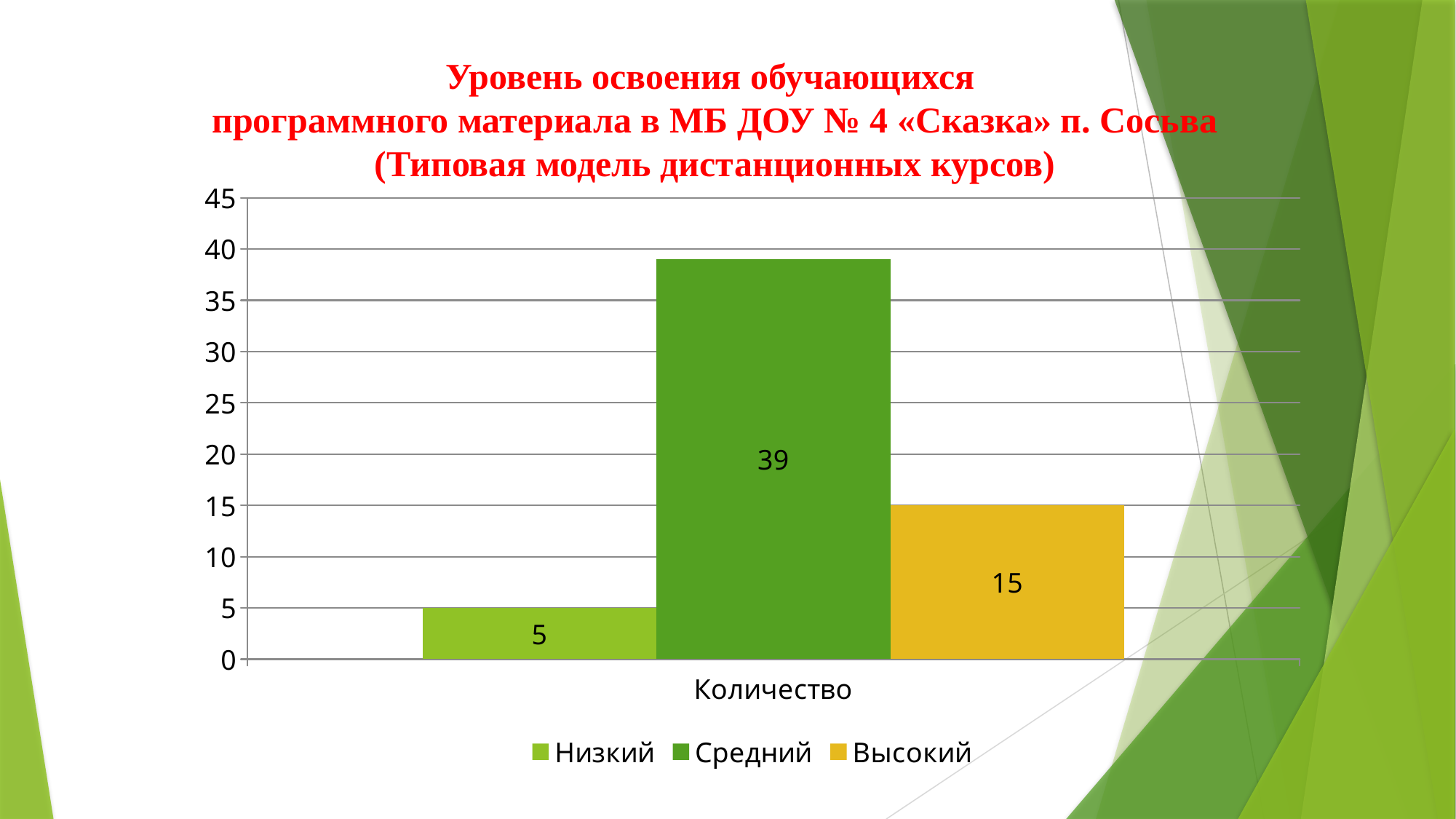
What kind of chart is shown on the slide? bar chart What is the value for Высокий? 15 Which series has the lowest value? Низкий What is the difference between the values for Средний and Высокий? 24 What is the value for Низкий? 5 Which is larger, the value for Высокий or the value for Низкий? Высокий Which series has the highest value? Средний What is the value for Средний? 39 Is the value for Средний greater or less than 35? greater How many series does the legend list? 3 What is the difference between the values for Высокий and Низкий? 10 What is the label on the x axis category? Количество